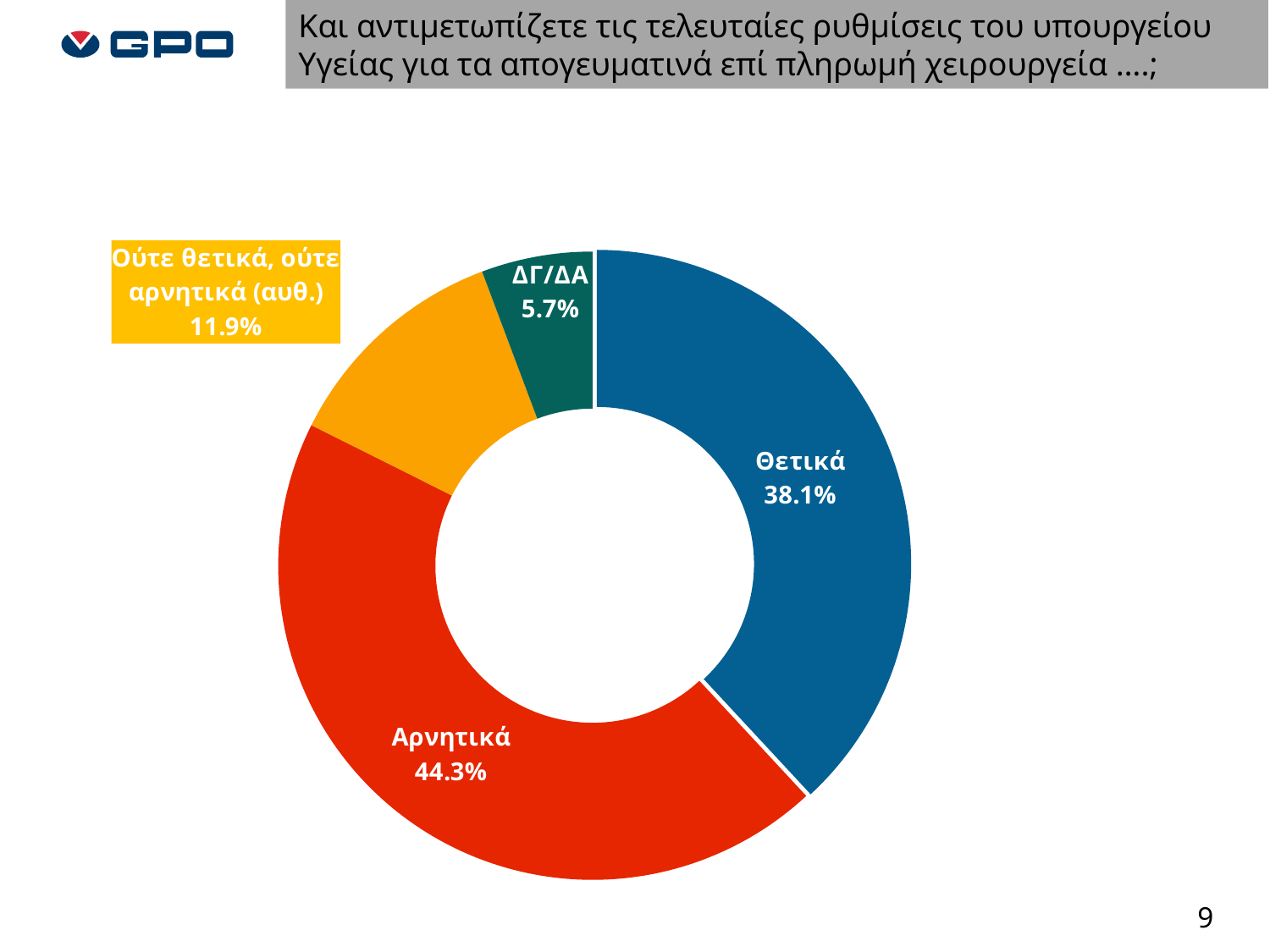
What colour is the Αρνητικά segment? Red What is the value shown for ΔΓ/ΔΑ? 5.7% What kind of chart is shown on the slide? Doughnut (pie) chart What percentage of respondents answered Αρνητικά? 44.3% What percentage of respondents answered Θετικά? 38.1% Which is larger, Θετικά or Ούτε θετικά, ούτε αρνητικά (αυθ.)? Θετικά What is the difference in percentage points between Αρνητικά and Θετικά? 6.2 What is the value shown for Ούτε θετικά, ούτε αρνητικά (αυθ.)? 11.9% Which category has the smallest share of the chart? ΔΓ/ΔΑ Which category has the largest share of the chart? Αρνητικά What is the combined share of Θετικά and Αρνητικά? 82.4% How many categories are shown in the chart? 4